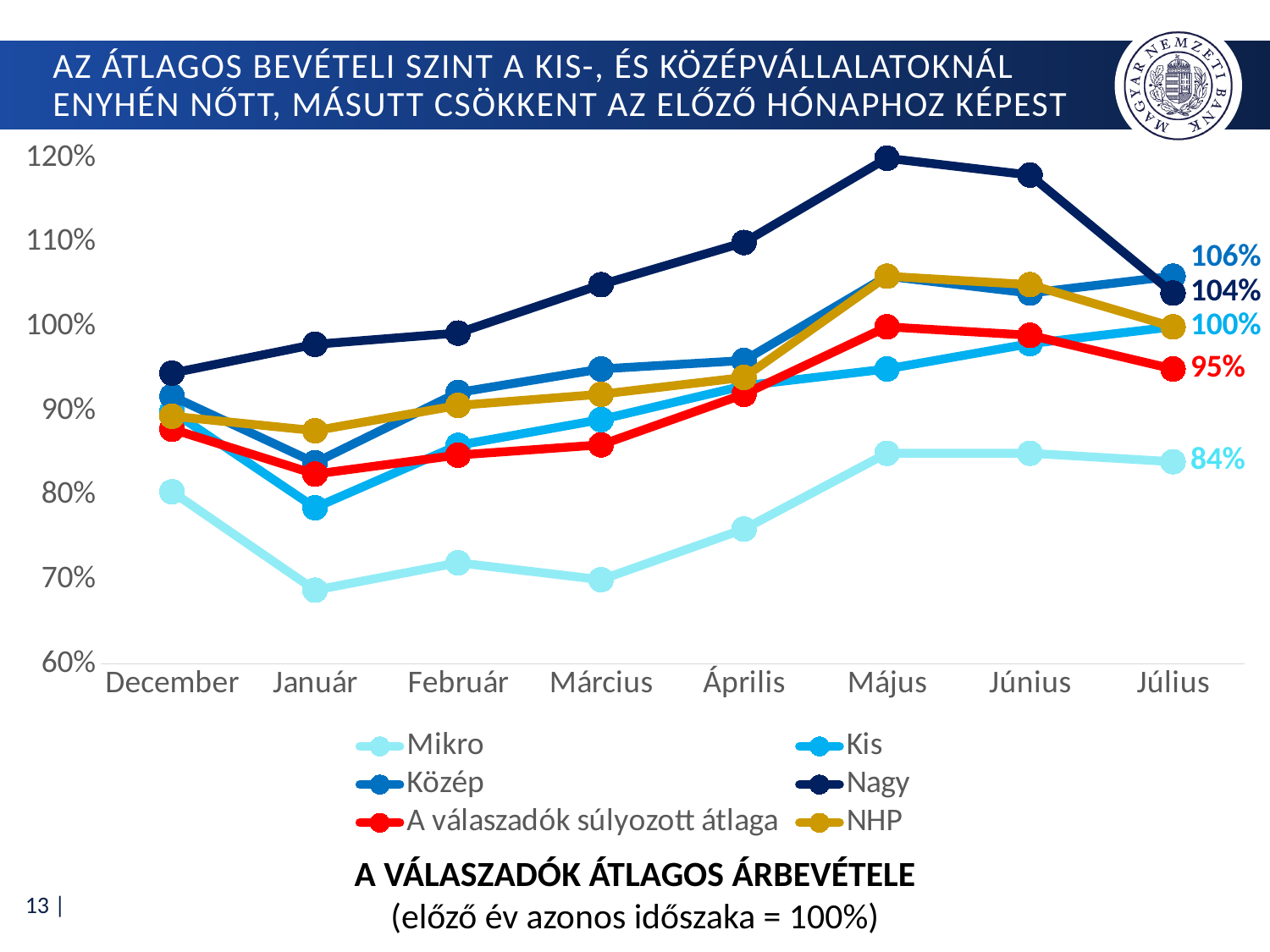
How many months are shown along the x axis? 8 Which series has the lowest value in Július? Mikro How many series does the legend list? 6 Is the value for Nagy in Május greater or less than 110%? greater What is the difference between the Közép and Mikro values in Július? 22 percentage points Which series has the highest value in Május? Nagy What kind of chart is shown on the slide? line chart What is the value for Nagy in Július? 104% Does the Nagy series rise or fall from Május to Július? fall What is the value for Közép in Július? 106% What is the value for Mikro in Július? 84% What is the value for 'A válaszadók súlyozott átlaga' in Július? 95%